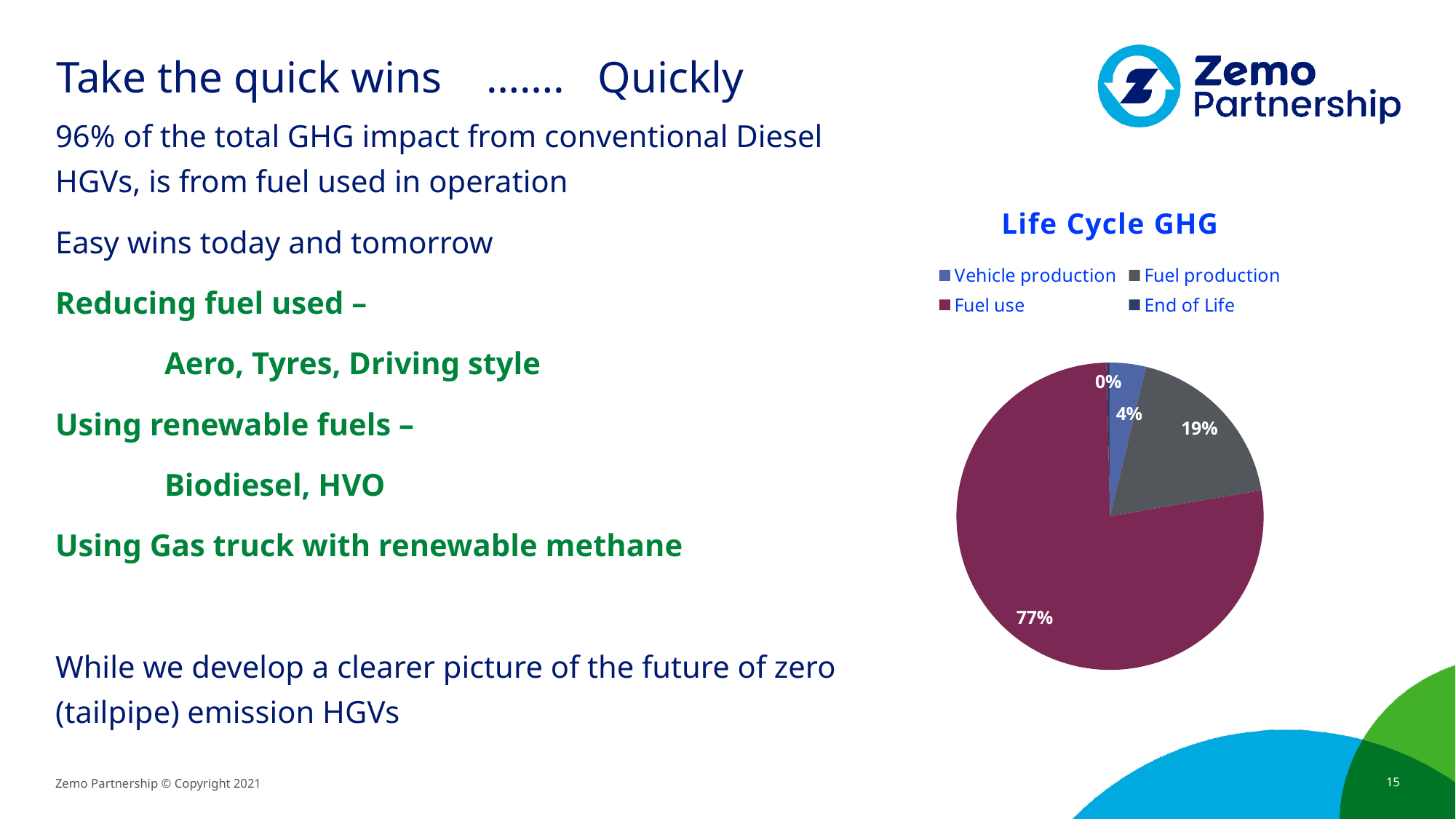
Which category has the largest share of the Life Cycle GHG pie? Fuel use What is the title of the chart? Life Cycle GHG In the Life Cycle GHG chart, how many percentage points larger is Fuel use than Fuel production? 58 What percentage of the Life Cycle GHG pie is Vehicle production? 4% What percentage of the Life Cycle GHG pie is End of Life? 0% What type of chart is shown on the slide? pie chart Which category has the smallest share of the Life Cycle GHG pie? End of Life What colour is the Fuel use slice in the Life Cycle GHG chart? maroon What percentage of the Life Cycle GHG pie is Fuel use? 77% What percentage of the Life Cycle GHG pie is Fuel production? 19% In the Life Cycle GHG chart, which is larger: Fuel production or Vehicle production? Fuel production How many categories does the legend of the Life Cycle GHG chart list? 4